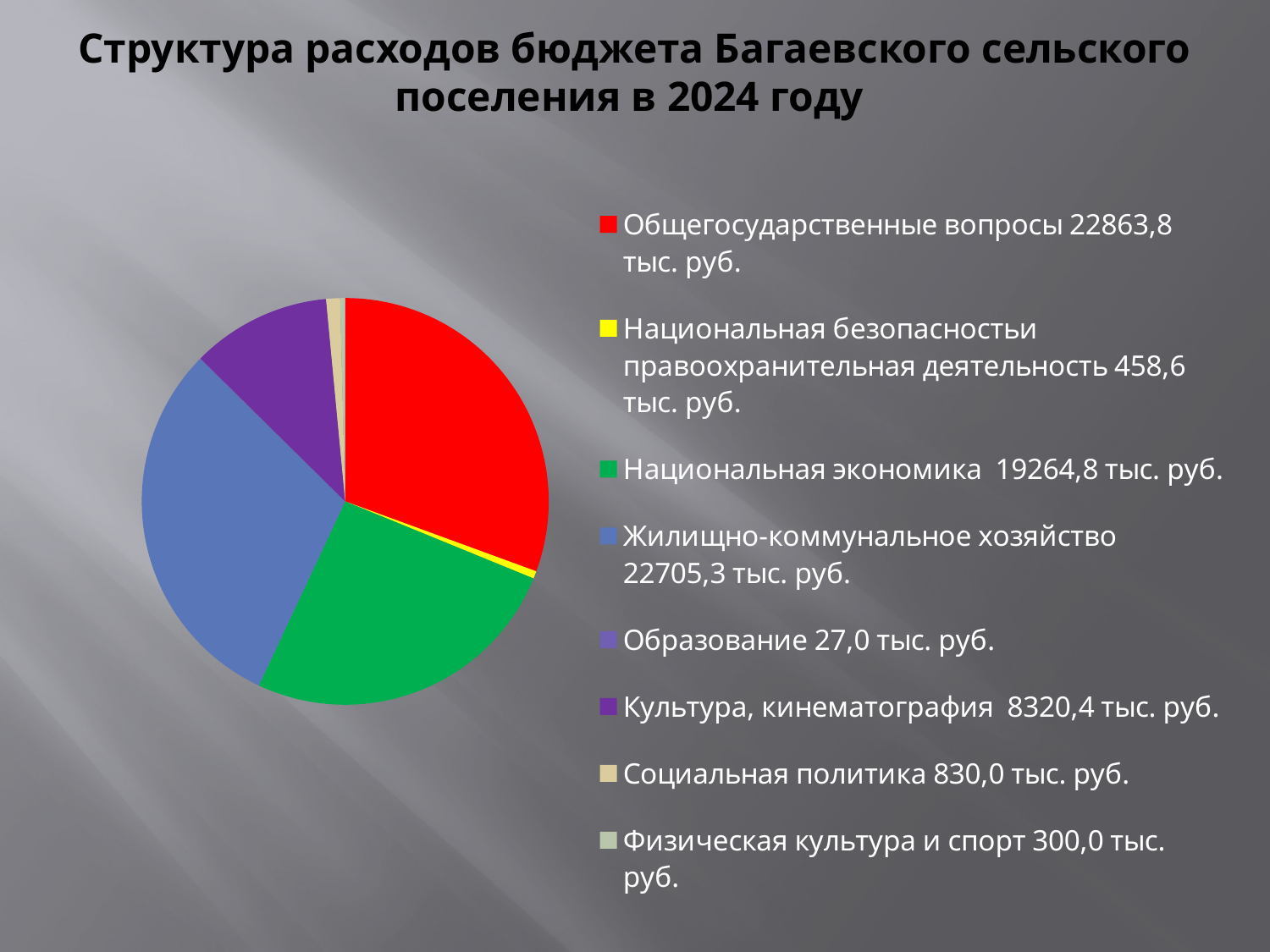
What colour is the slice for Национальная экономика? green What is the value for Образование? 27,0 тыс. руб. Which category has the smallest value? Образование How many categories does the pie chart have? 8 What is the difference between Социальная политика and Физическая культура и спорт? 530,0 тыс. руб. What is the value for Общегосударственные вопросы? 22863,8 тыс. руб. What is the value for Жилищно-коммунальное хозяйство? 22705,3 тыс. руб. Which category has the largest value? Общегосударственные вопросы What is the difference between Национальная экономика and Культура, кинематография? 10944,4 тыс. руб. What kind of chart is shown on the slide? pie chart Which is larger: Национальная экономика or Жилищно-коммунальное хозяйство? Жилищно-коммунальное хозяйство What is the value for Культура, кинематография? 8320,4 тыс. руб.